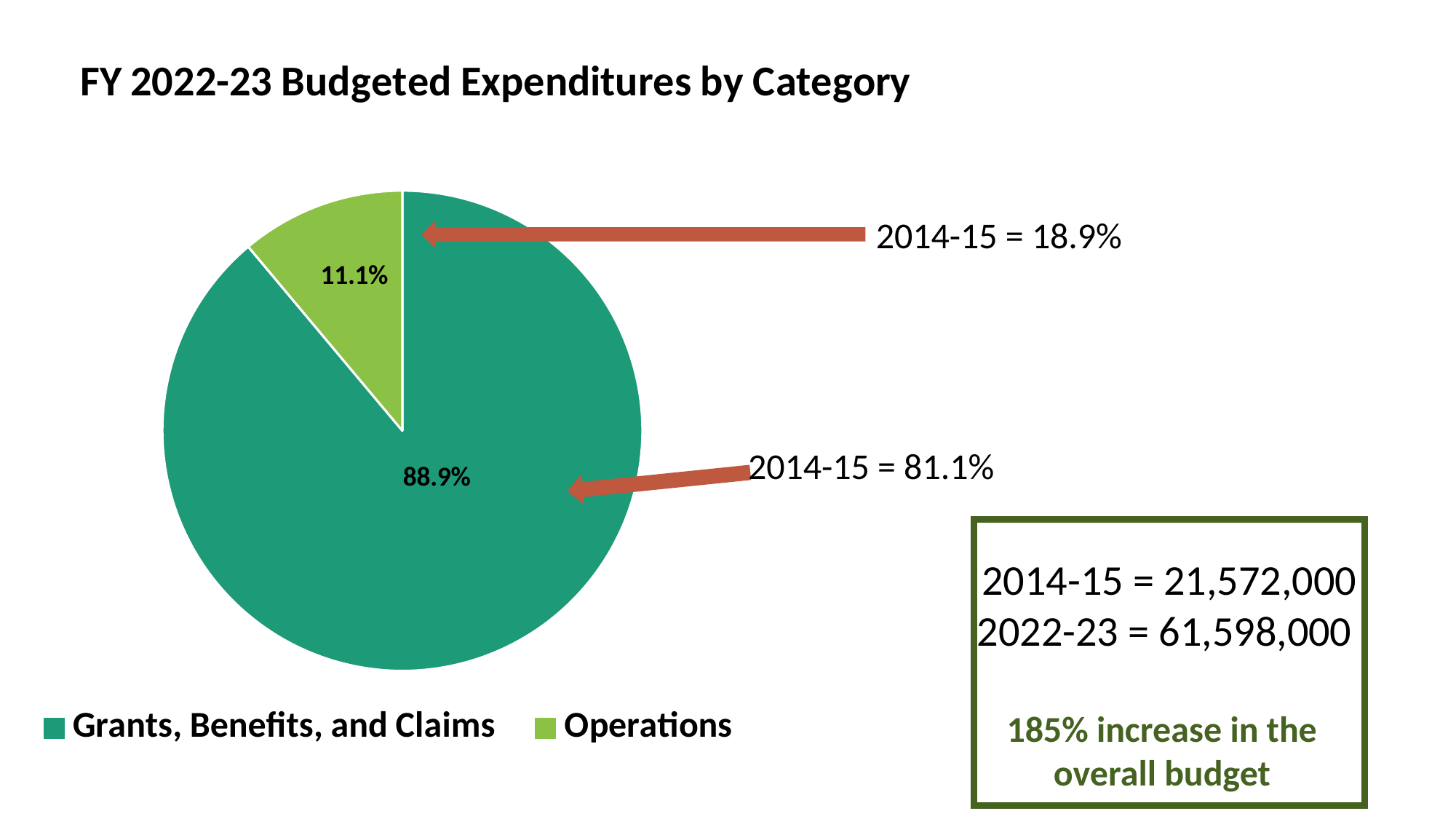
What share of the pie is Operations? 11.1% Which category is shown in light green in the legend? Operations Which is larger, the Operations slice or the Grants, Benefits, and Claims slice? Grants, Benefits, and Claims Which category has the smallest slice of the pie? Operations Which category has the largest slice of the pie? Grants, Benefits, and Claims What is the title of the chart? FY 2022-23 Budgeted Expenditures by Category What kind of chart is shown on the slide? pie chart How many categories does the pie chart show? 2 According to the annotation, what was the Operations share in 2014-15? 18.9% What is the difference in percentage points between the Grants, Benefits, and Claims slice and the Operations slice? 77.8 According to the annotation, what was the Grants, Benefits, and Claims share in 2014-15? 81.1% What share of the pie is Grants, Benefits, and Claims? 88.9%